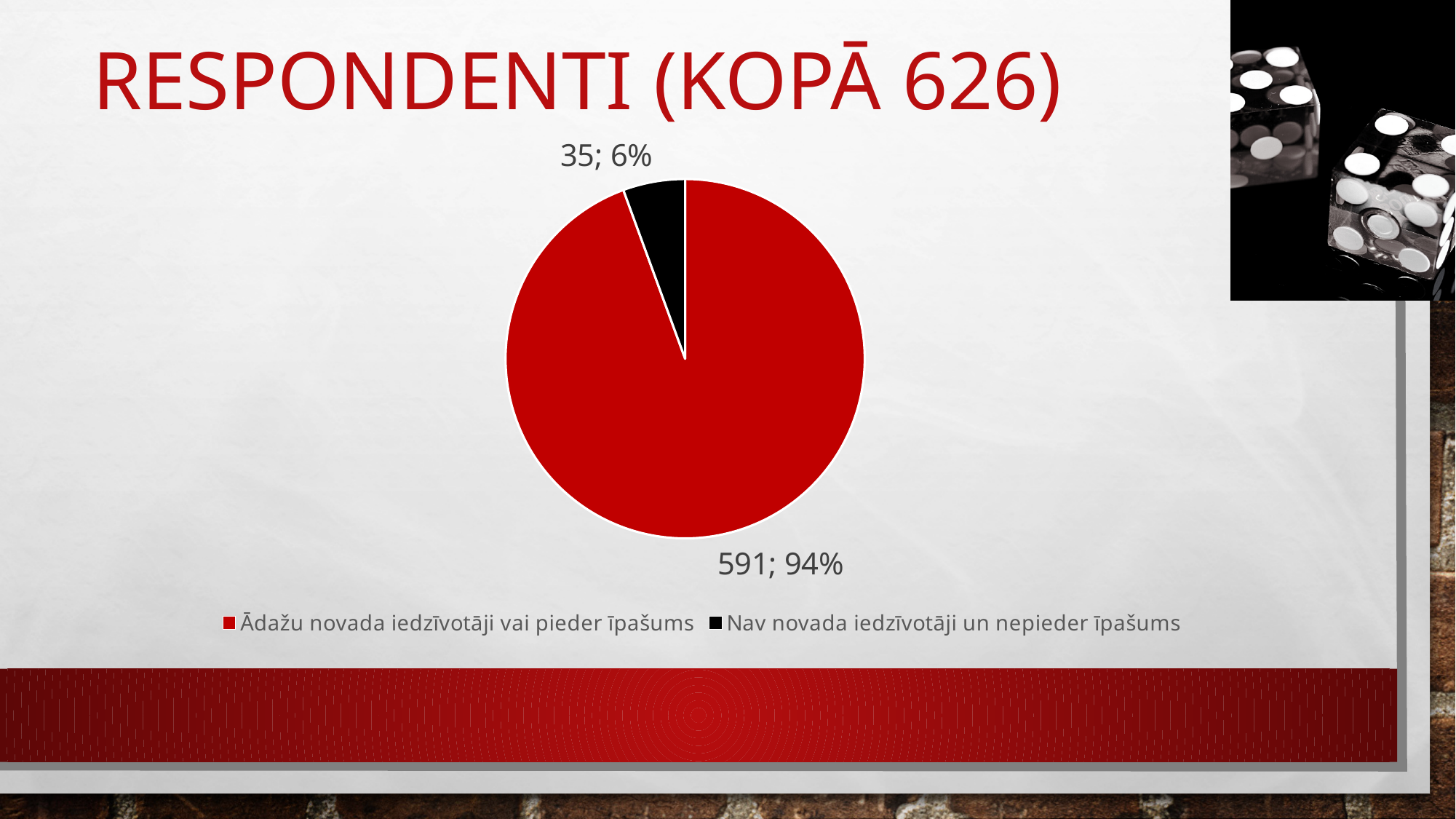
What is the total number of respondents across both slices? 626 Which category has the smallest slice? Nav novada iedzīvotāji un nepieder īpašums What share of the pie does 'Ādažu novada iedzīvotāji vai pieder īpašums' represent? 94% What kind of chart is shown on the slide? pie chart How many respondents are in the category 'Ādažu novada iedzīvotāji vai pieder īpašums'? 591 How many slices does the pie chart have? 2 What share of the pie does 'Nav novada iedzīvotāji un nepieder īpašums' represent? 6% How many respondents are in the category 'Nav novada iedzīvotāji un nepieder īpašums'? 35 How many entries does the legend list? 2 What is the difference in respondent count between 'Ādažu novada iedzīvotāji vai pieder īpašums' and 'Nav novada iedzīvotāji un nepieder īpašums'? 556 What colour is the slice for 'Nav novada iedzīvotāji un nepieder īpašums'? black Which category has the largest slice? Ādažu novada iedzīvotāji vai pieder īpašums